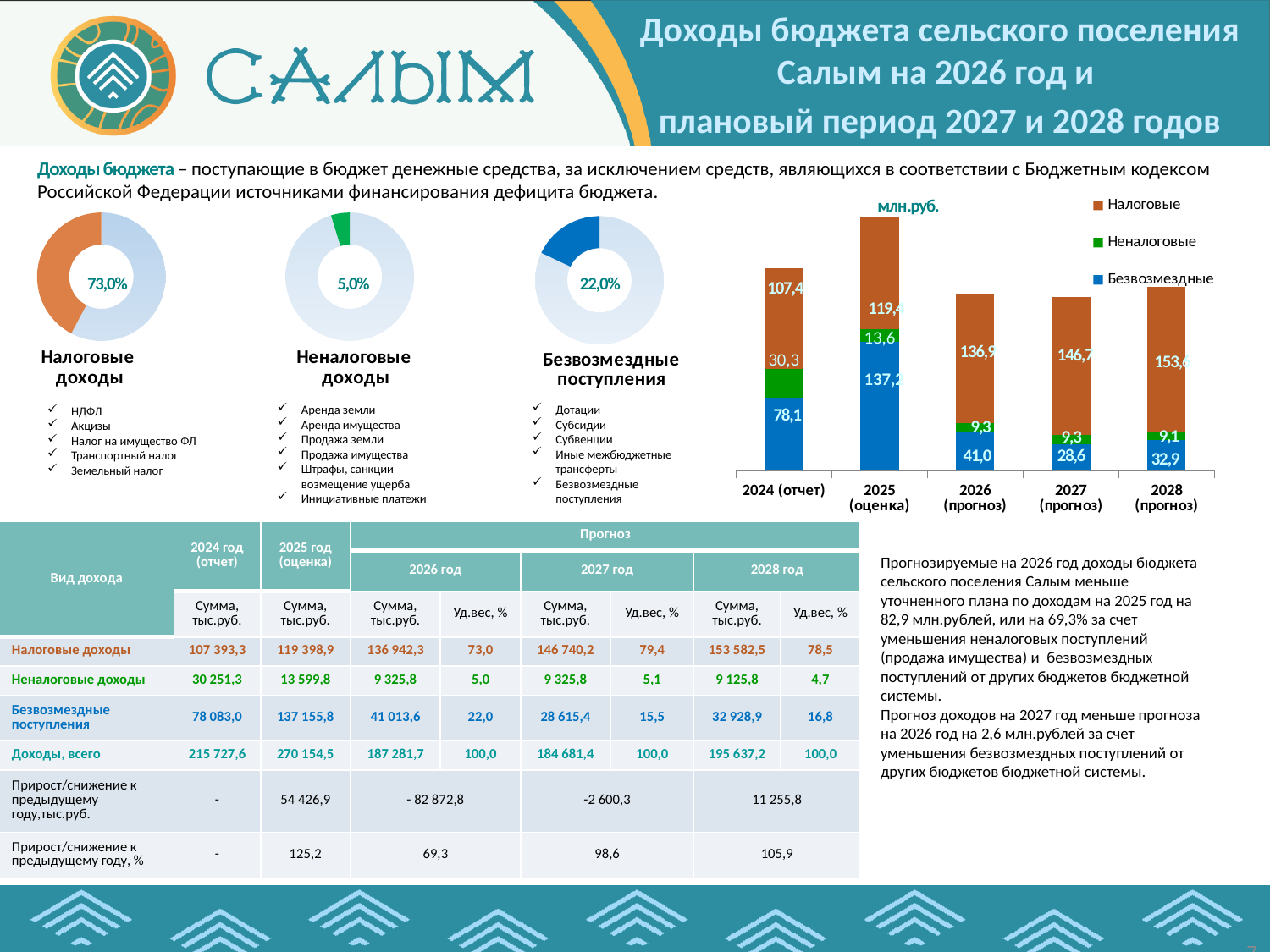
In the stacked bar chart, what is the value of Неналоговые for 2028 (прогноз)? 9,1 In the stacked bar chart, what is the value of Налоговые for 2025 (оценка)? 119,4 How many year categories are shown on the x axis of the stacked bar chart? 5 In the stacked bar chart, what is the difference between the Безвозмездные values for 2025 (оценка) and 2026 (прогноз)? 96,2 What share does the donut chart labelled Налоговые доходы show? 73,0% In the stacked bar chart, what is the value of Безвозмездные for 2024 (отчет)? 78,1 In the stacked bar chart, which is larger: Неналоговые for 2024 (отчет) or Неналоговые for 2025 (оценка)? 2024 (отчет) What kind of chart is the chart with the years 2024–2028 on the x axis? Stacked bar chart In the stacked bar chart, what is the total of the stacked bar for 2024 (отчет)? 215,8 In the stacked bar chart, which year has the highest Безвозмездные value? 2025 (оценка) How many series does the legend of the stacked bar chart list? 3 In the stacked bar chart, which year has the lowest Налоговые value? 2024 (отчет)